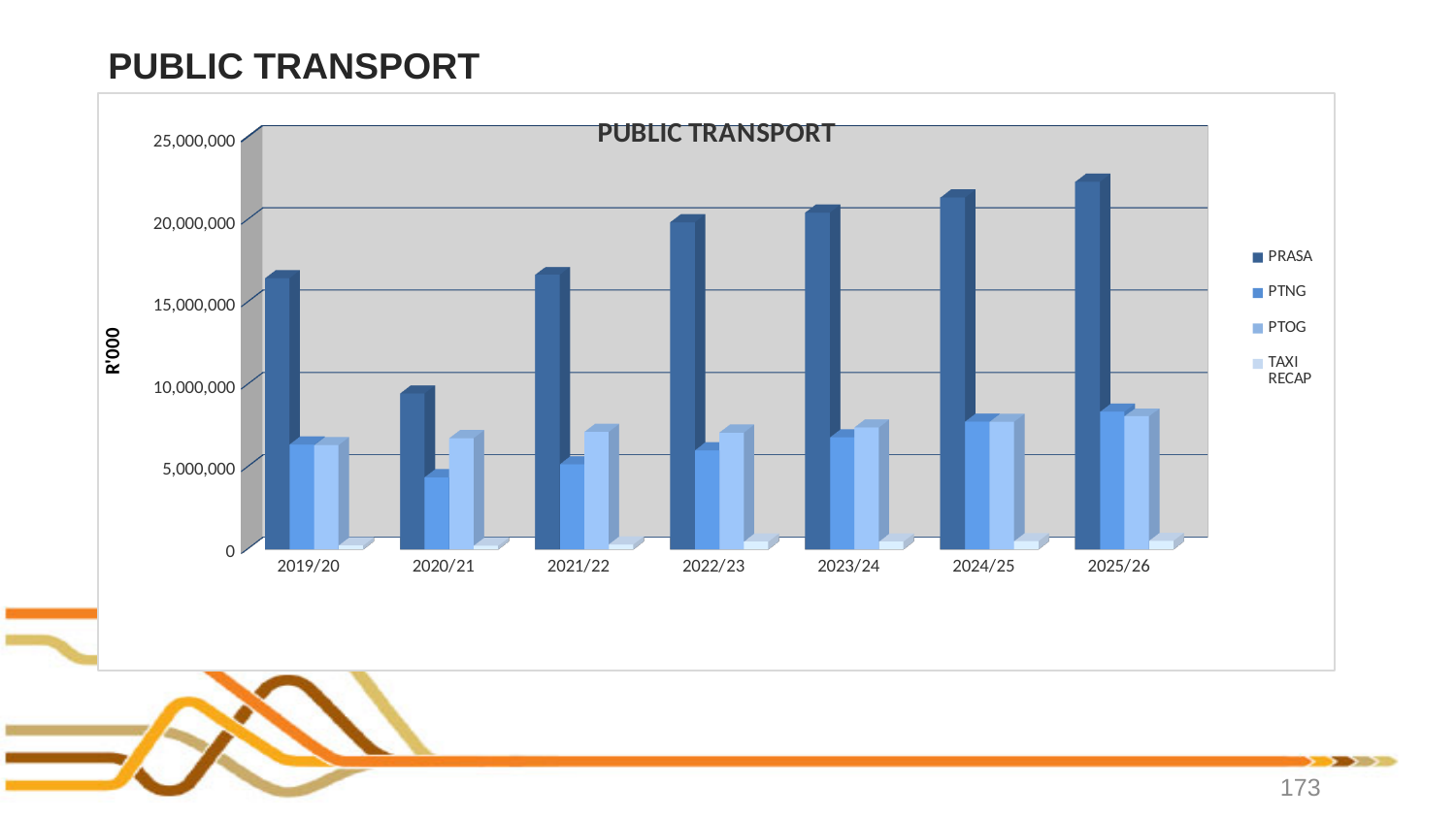
In which year is the PRASA value lowest? 2020/21 Is the PRASA value for 2025/26 greater or less than 20,000,000? greater How many financial years are shown on the x axis of the chart? 7 What is the label on the vertical axis of the chart? R'000 What is the title of the chart? PUBLIC TRANSPORT How many series does the chart legend list? 4 Does the PRASA value rise or fall from 2020/21 to 2025/26? rise Is the PRASA value for 2019/20 greater or less than 15,000,000? greater Is the PTNG value for 2020/21 greater or less than 5,000,000? less What kind of chart is shown on the slide? Bar chart In 2020/21, which is larger: the PTNG value or the PTOG value? PTOG In which year is the PRASA value highest? 2025/26